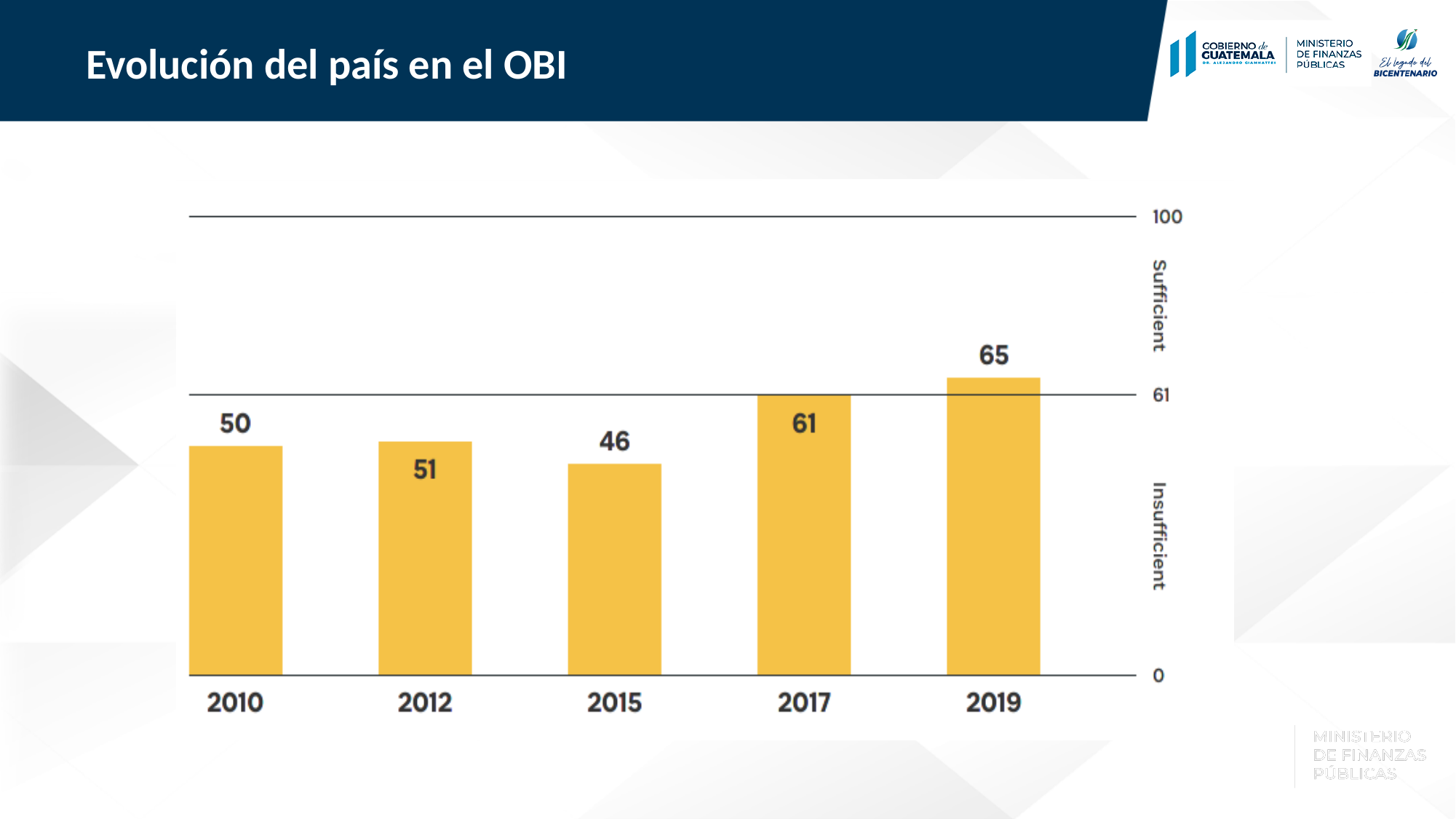
Which year has the highest value? 2019 What is the difference between the values for 2019 and 2010? 15 How many years are shown on the x axis? 5 Which year has the lowest value? 2015 What is the value for 2015? 46 What is the value for 2010? 50 Which is larger, the value for 2012 or the value for 2017? 2017 What is the difference between the values for 2012 and 2015? 5 What kind of chart is shown on the slide? Bar chart What is the value for 2017? 61 What is the value for 2019? 65 What is the title of the slide containing the chart? Evolución del país en el OBI